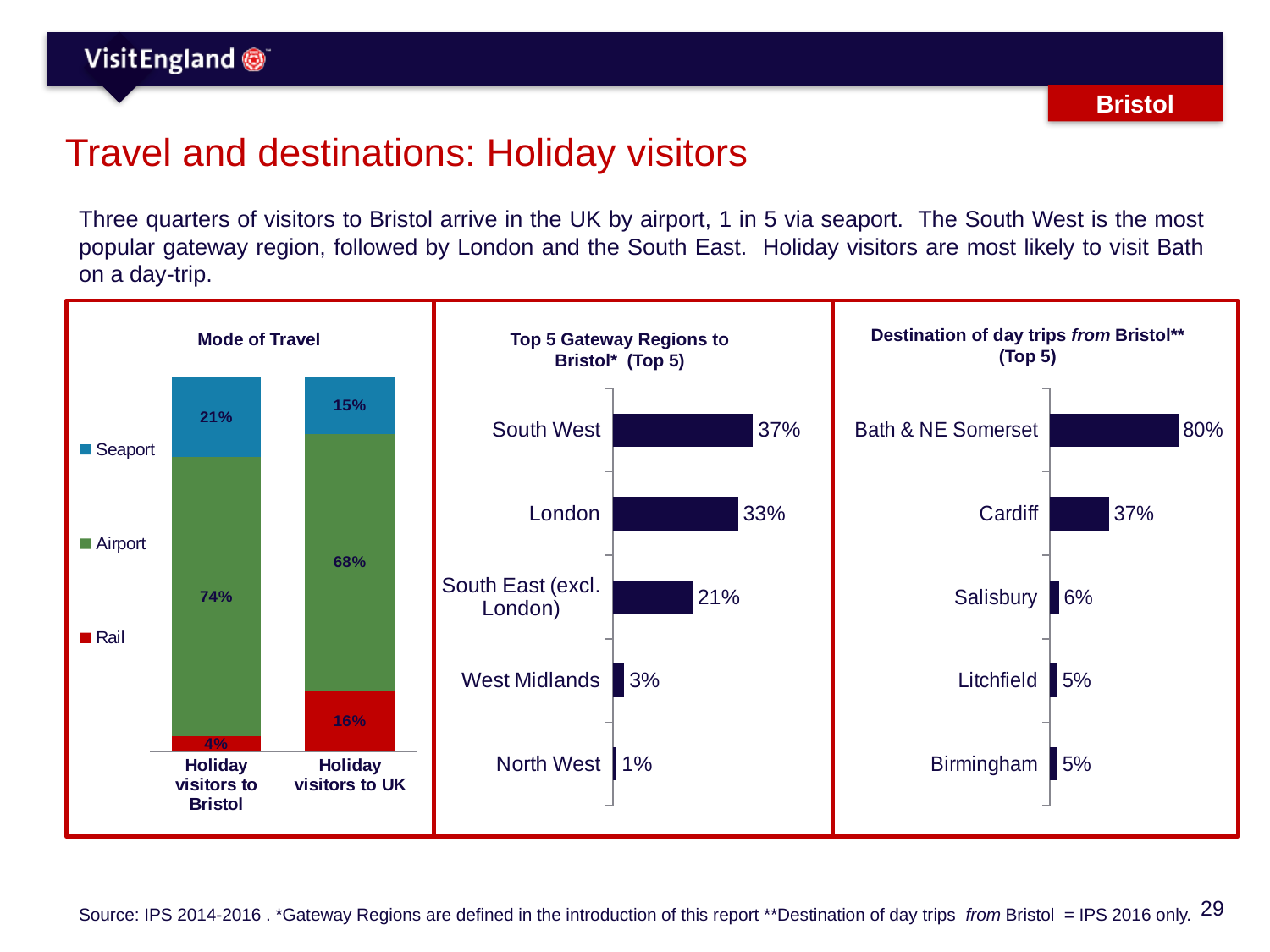
In the Destination of day trips from Bristol chart, which destination has the highest value? Bath & NE Somerset In the Top 5 Gateway Regions to Bristol chart, what is the difference between South West and South East (excl. London)? 16 percentage points In the Mode of Travel chart, what is the difference between the rail share for holiday visitors to the UK and for holiday visitors to Bristol? 12 percentage points In the Mode of Travel chart, which colour represents Airport? Green In the Top 5 Gateway Regions to Bristol chart, what is the value for London? 33% In the Mode of Travel chart, how many series does the legend list? 3 In the Destination of day trips from Bristol chart, how many destinations are shown? 5 In the Top 5 Gateway Regions to Bristol chart, which region has the lowest value? North West What kind of chart is the Top 5 Gateway Regions to Bristol chart? Bar chart In the Destination of day trips from Bristol chart, what is the value for Cardiff? 37% In the Mode of Travel chart, what percentage of holiday visitors to Bristol arrive by airport? 74% In the Mode of Travel chart, what percentage of holiday visitors to the UK arrive by seaport? 15%